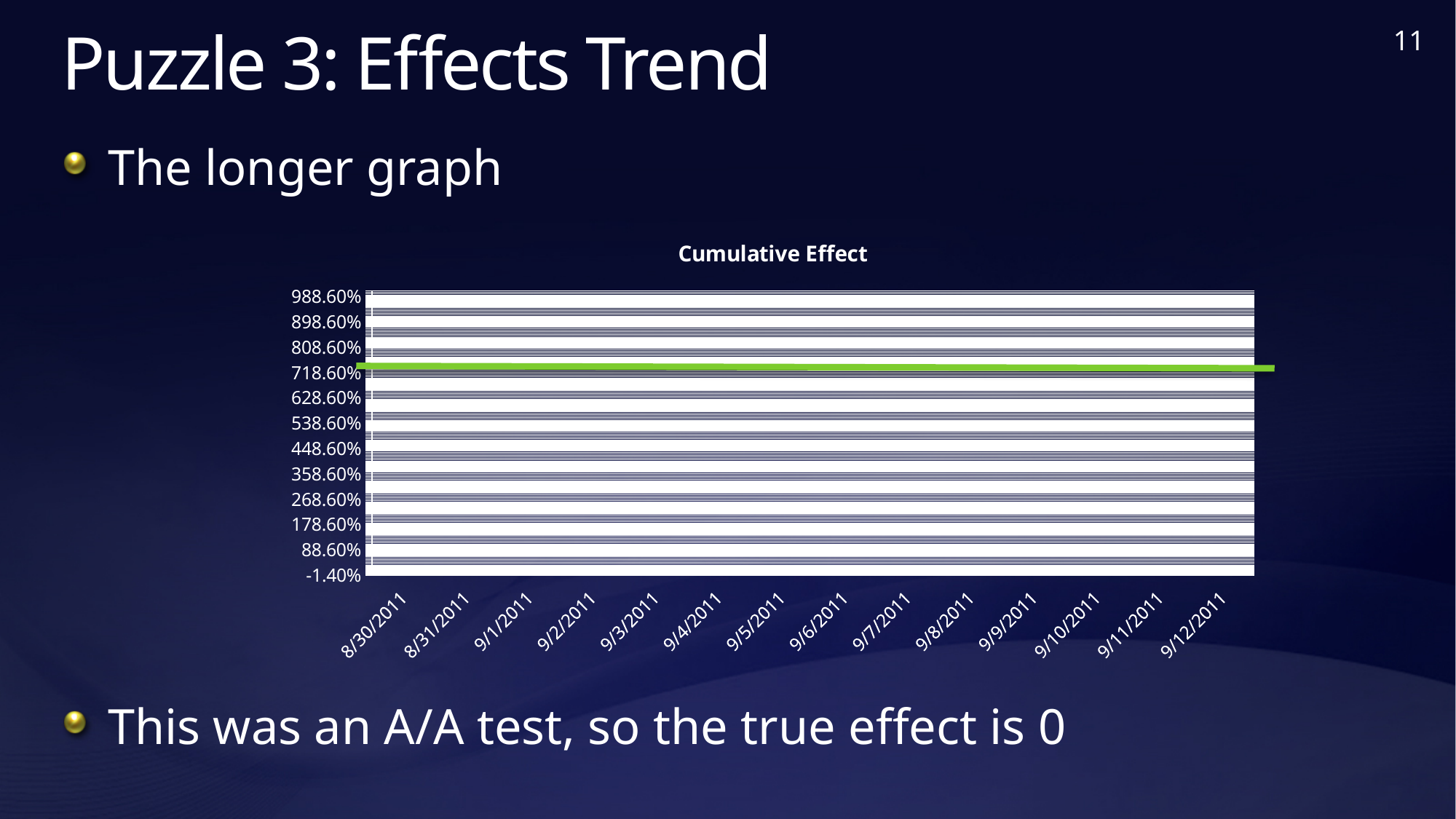
How many dates are shown on the x axis of the chart? 14 What is the first date on the x axis of the chart? 8/30/2011 Does the line rise sharply, fall sharply, or stay roughly flat from 8/30/2011 to 9/12/2011? stays roughly flat What is the highest tick label on the y axis of the chart? 988.60% Is the value for 9/12/2011 greater or less than 808.60%? less Is the value for 9/5/2011 greater or less than 448.60%? greater What is the title of the chart? Cumulative Effect What kind of chart is shown on the slide? line chart Is the value for 9/1/2011 greater or less than 898.60%? less